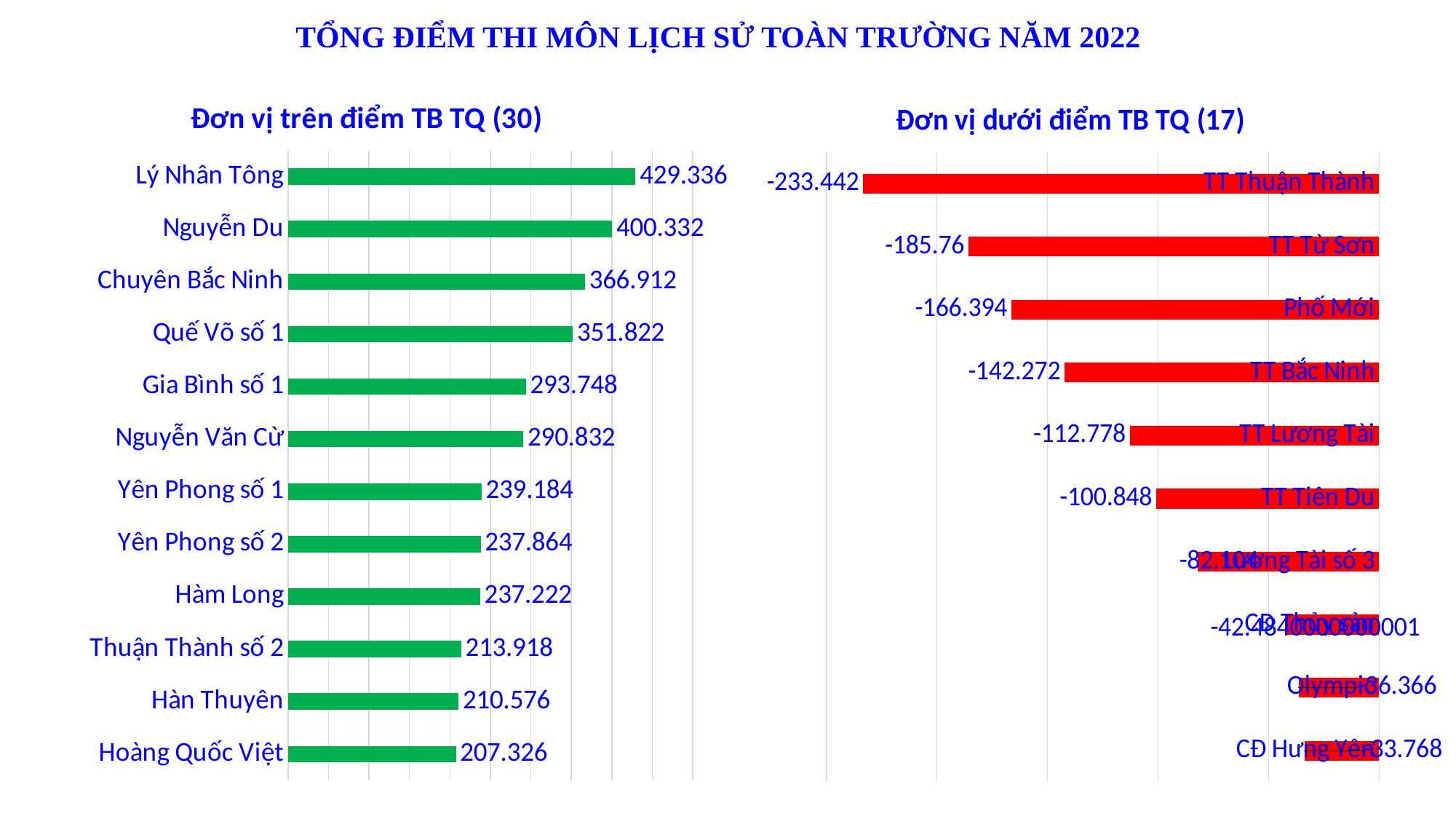
In the chart titled "Đơn vị trên điểm TB TQ (30)", which category has the lowest value? Hoàng Quốc Việt In the chart titled "Đơn vị dưới điểm TB TQ (17)", what is the value for TT Thuận Thành? -233.442 In the chart titled "Đơn vị trên điểm TB TQ (30)", what is the value for Lý Nhân Tông? 429.336 In the chart titled "Đơn vị dưới điểm TB TQ (17)", which category has the lowest (most negative) value? TT Thuận Thành In the chart titled "Đơn vị trên điểm TB TQ (30)", which is larger: the value for Chuyên Bắc Ninh or the value for Gia Bình số 1? Chuyên Bắc Ninh In the chart titled "Đơn vị trên điểm TB TQ (30)", what is the difference between the values for Lý Nhân Tông and Nguyễn Du? 29.004 In the chart titled "Đơn vị dưới điểm TB TQ (17)", what is the value for Phố Mới? -166.394 In the chart titled "Đơn vị trên điểm TB TQ (30)", what is the value for Hoàng Quốc Việt? 207.326 In the chart titled "Đơn vị trên điểm TB TQ (30)", which category has the highest value? Lý Nhân Tông How many categories are shown in the chart titled "Đơn vị trên điểm TB TQ (30)"? 12 What kind of chart is the chart titled "Đơn vị trên điểm TB TQ (30)"? Bar chart In the chart titled "Đơn vị dưới điểm TB TQ (17)", which is larger: the value for TT Tiên Du or the value for TT Từ Sơn? TT Tiên Du